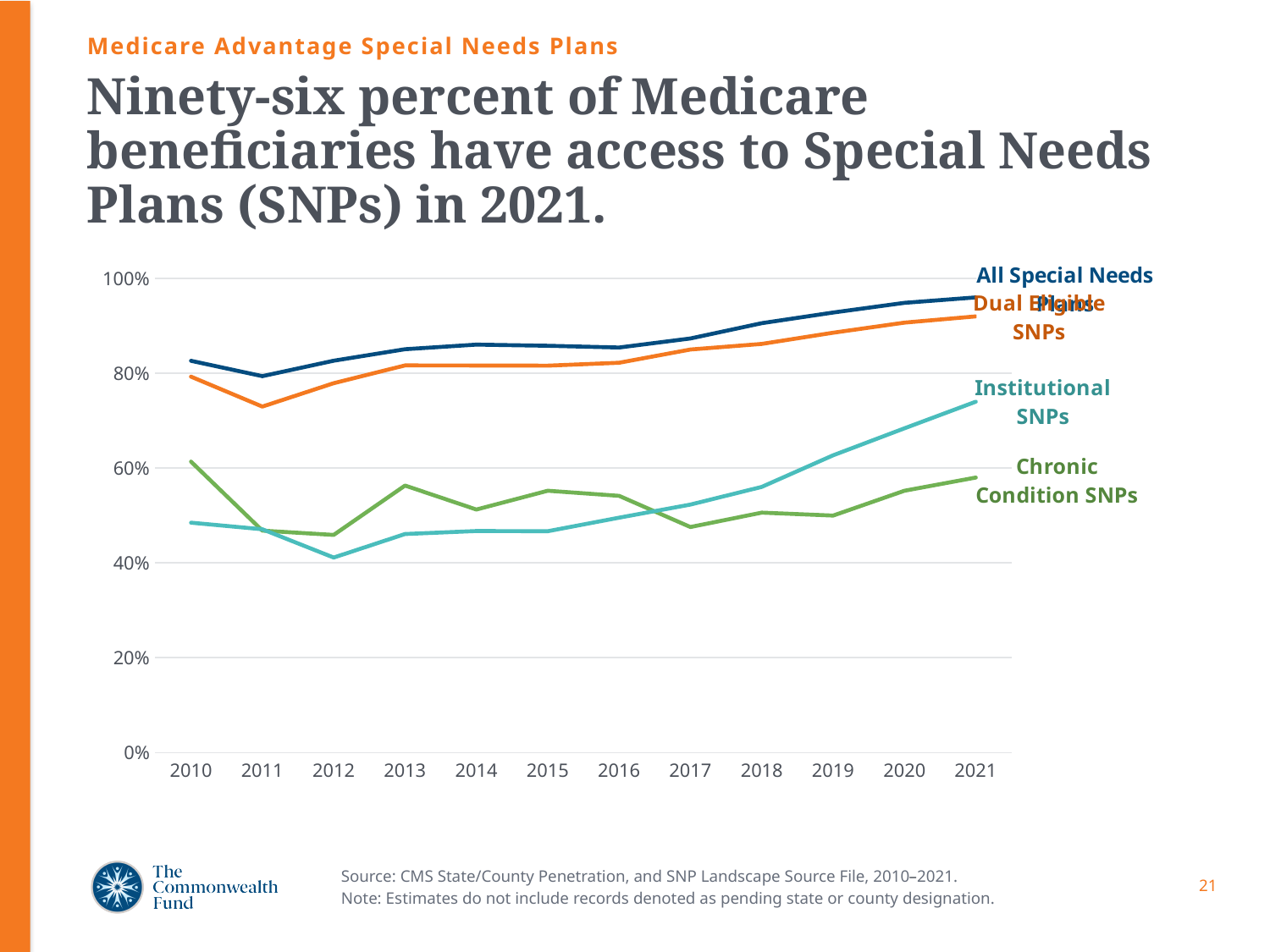
How many series does the chart show? 4 In 2010, which is larger: Chronic Condition SNPs or Institutional SNPs? Chronic Condition SNPs How many years are plotted along the x axis? 12 What colour is the line for Dual Eligible SNPs? Orange Which series has the highest value in 2021? All Special Needs Plans Is the value for Chronic Condition SNPs in 2017 greater or less than 60%? less Does the All Special Needs Plans line generally rise or fall from 2012 to 2021? Rise In 2021, which is larger: Institutional SNPs or Chronic Condition SNPs? Institutional SNPs Which series has the lowest value in 2021? Chronic Condition SNPs What kind of chart is shown on the slide? Line chart Is the value for Institutional SNPs in 2021 greater or less than 60%? greater Is the value for Dual Eligible SNPs in 2011 greater or less than 80%? less